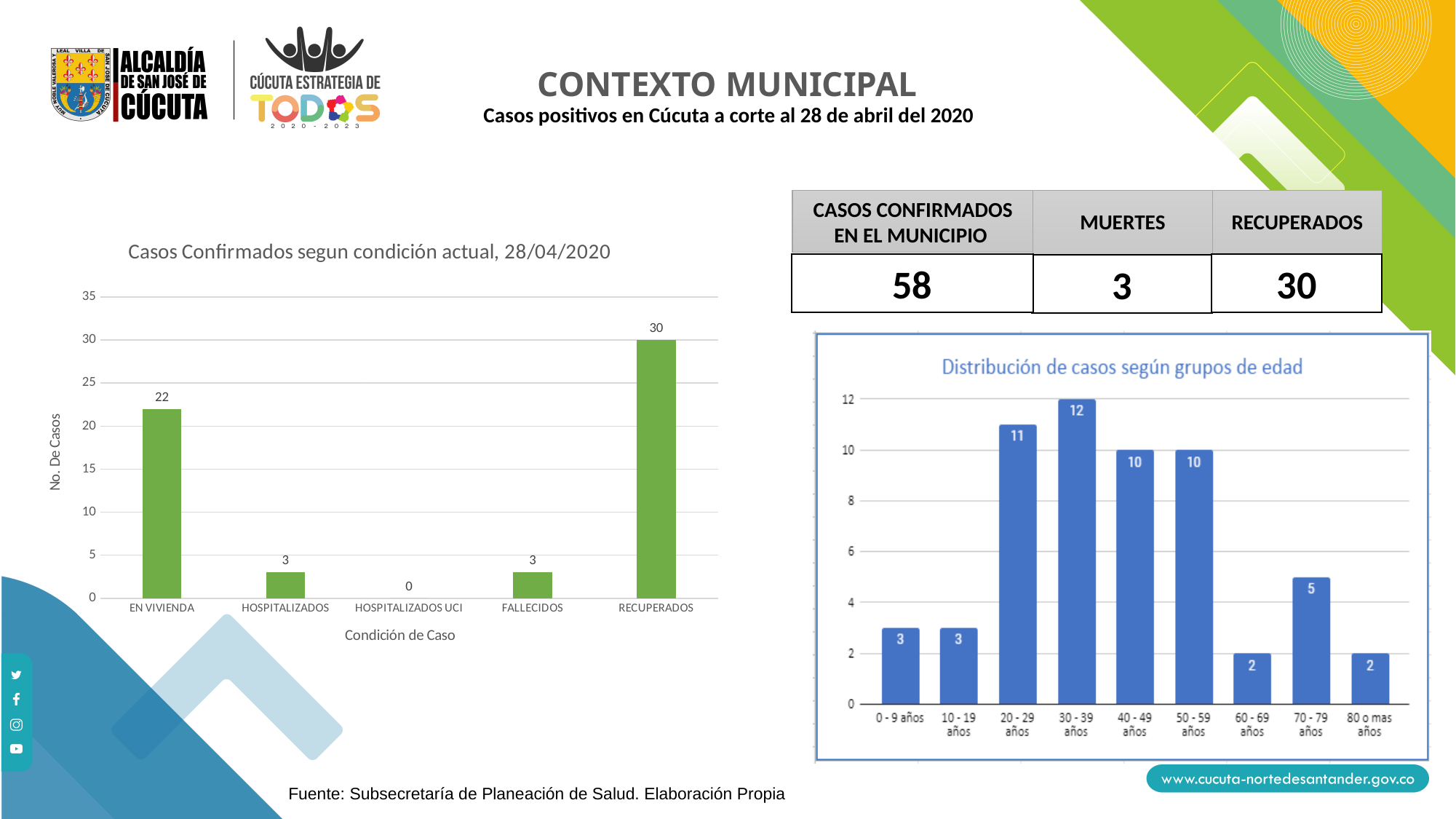
What is the y-axis label of the chart 'Casos Confirmados segun condición actual, 28/04/2020'? No. De Casos In the chart 'Distribución de casos según grupos de edad', which is larger, 20 - 29 años or 70 - 79 años? 20 - 29 años In the chart 'Distribución de casos según grupos de edad', what is the difference between 20 - 29 años and 60 - 69 años? 9 In the chart 'Distribución de casos según grupos de edad', how many age groups are shown on the x axis? 9 In the chart 'Casos Confirmados segun condición actual, 28/04/2020', what is the difference between RECUPERADOS and EN VIVIENDA? 8 What kind of chart is 'Casos Confirmados segun condición actual, 28/04/2020'? Bar chart In the chart 'Casos Confirmados segun condición actual, 28/04/2020', which category has the lowest value? HOSPITALIZADOS UCI In the chart 'Casos Confirmados segun condición actual, 28/04/2020', which category has the highest value? RECUPERADOS In the chart 'Distribución de casos según grupos de edad', which age group has the highest value? 30 - 39 años In the chart 'Distribución de casos según grupos de edad', what is the value for 30 - 39 años? 12 In the chart 'Casos Confirmados segun condición actual, 28/04/2020', how many categories are shown on the x axis? 5 In the chart 'Casos Confirmados segun condición actual, 28/04/2020', what is the value for EN VIVIENDA? 22